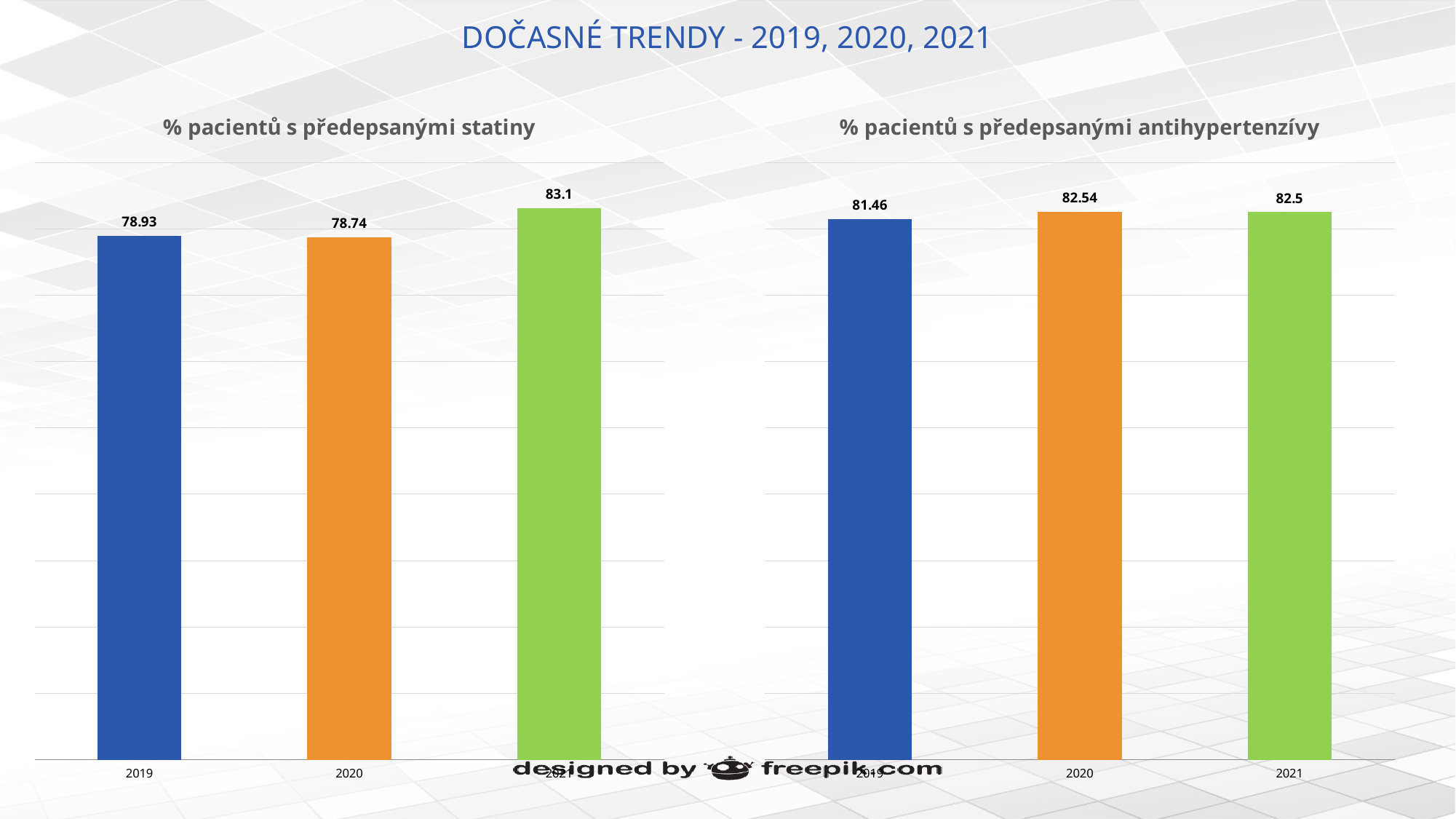
In the chart titled '% pacientů s předepsanými statiny', what is the difference between the values for 2021 and 2019? 4.17 In the chart titled '% pacientů s předepsanými statiny', what is the value for 2021? 83.1 In the chart titled '% pacientů s předepsanými statiny', which year has the highest value? 2021 In the chart titled '% pacientů s předepsanými statiny', which year has the lowest value? 2020 In the chart titled '% pacientů s předepsanými statiny', which is larger, the value for 2019 or the value for 2021? 2021 How many bars are shown in the chart titled '% pacientů s předepsanými antihypertenzívy'? 3 In the chart titled '% pacientů s předepsanými statiny', what is the value for 2019? 78.93 In the chart titled '% pacientů s předepsanými antihypertenzívy', what is the difference between the values for 2020 and 2019? 1.08 In the chart titled '% pacientů s předepsanými antihypertenzívy', what is the value for 2019? 81.46 In the chart titled '% pacientů s předepsanými antihypertenzívy', which year has the lowest value? 2019 What type of chart is the chart titled '% pacientů s předepsanými statiny'? Bar chart In the chart titled '% pacientů s předepsanými antihypertenzívy', what is the value for 2020? 82.54